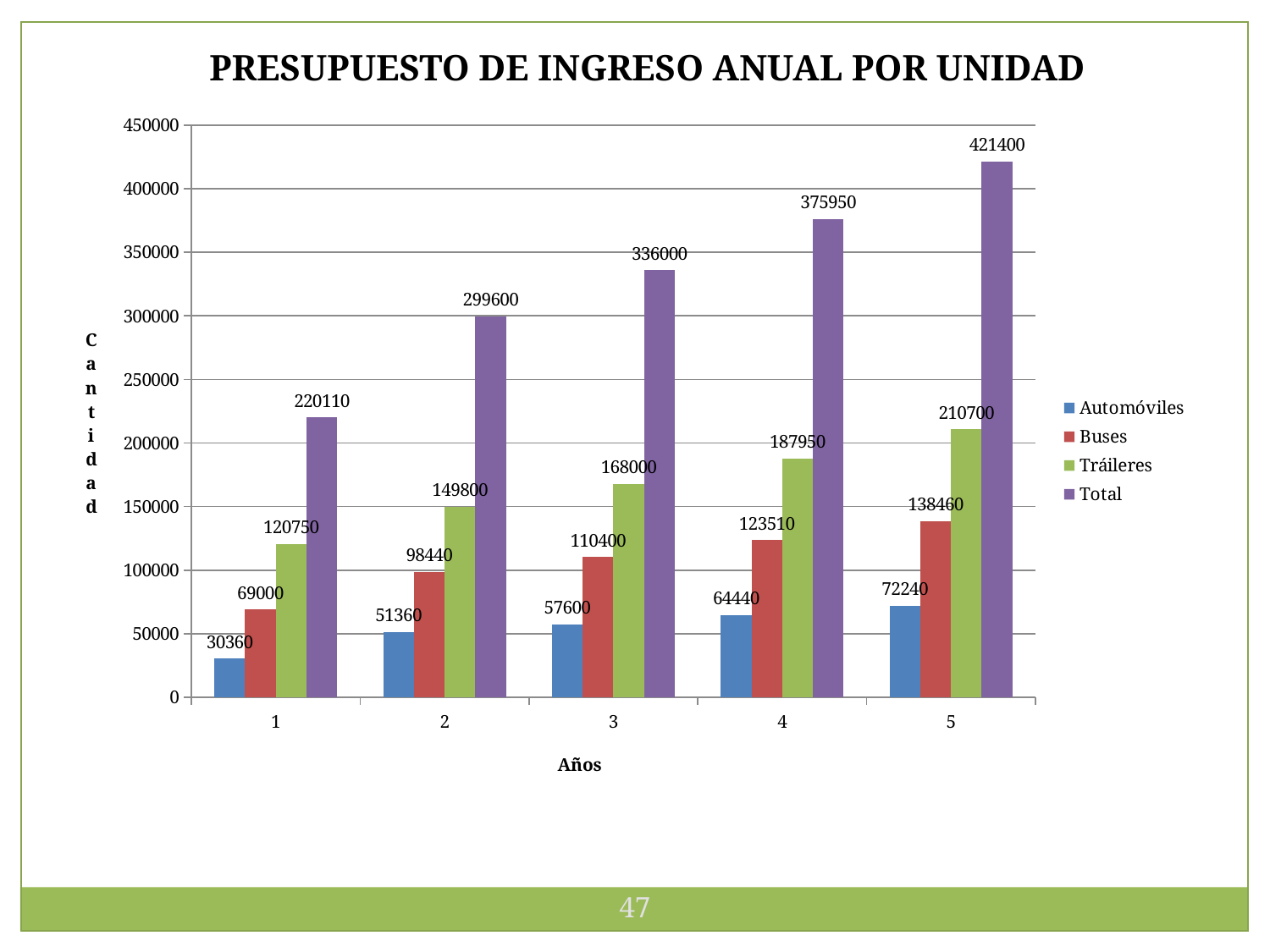
How many years are shown on the x axis? 5 How many series does the legend list? 4 What kind of chart is shown on the slide? Bar chart In which year is the Total value highest? 5 Do the Total values rise or fall from year 1 to year 5? Rise What is the difference between the Total values in year 5 and year 4? 45450 What is the value for Buses in year 3? 110400 What is the Total value in year 5? 421400 What is the value for Tráileres in year 4? 187950 Which is larger: Buses in year 5 or Tráileres in year 1? Buses in year 5 What is the value for Automóviles in year 1? 30360 In which year is the Automóviles value lowest? 1